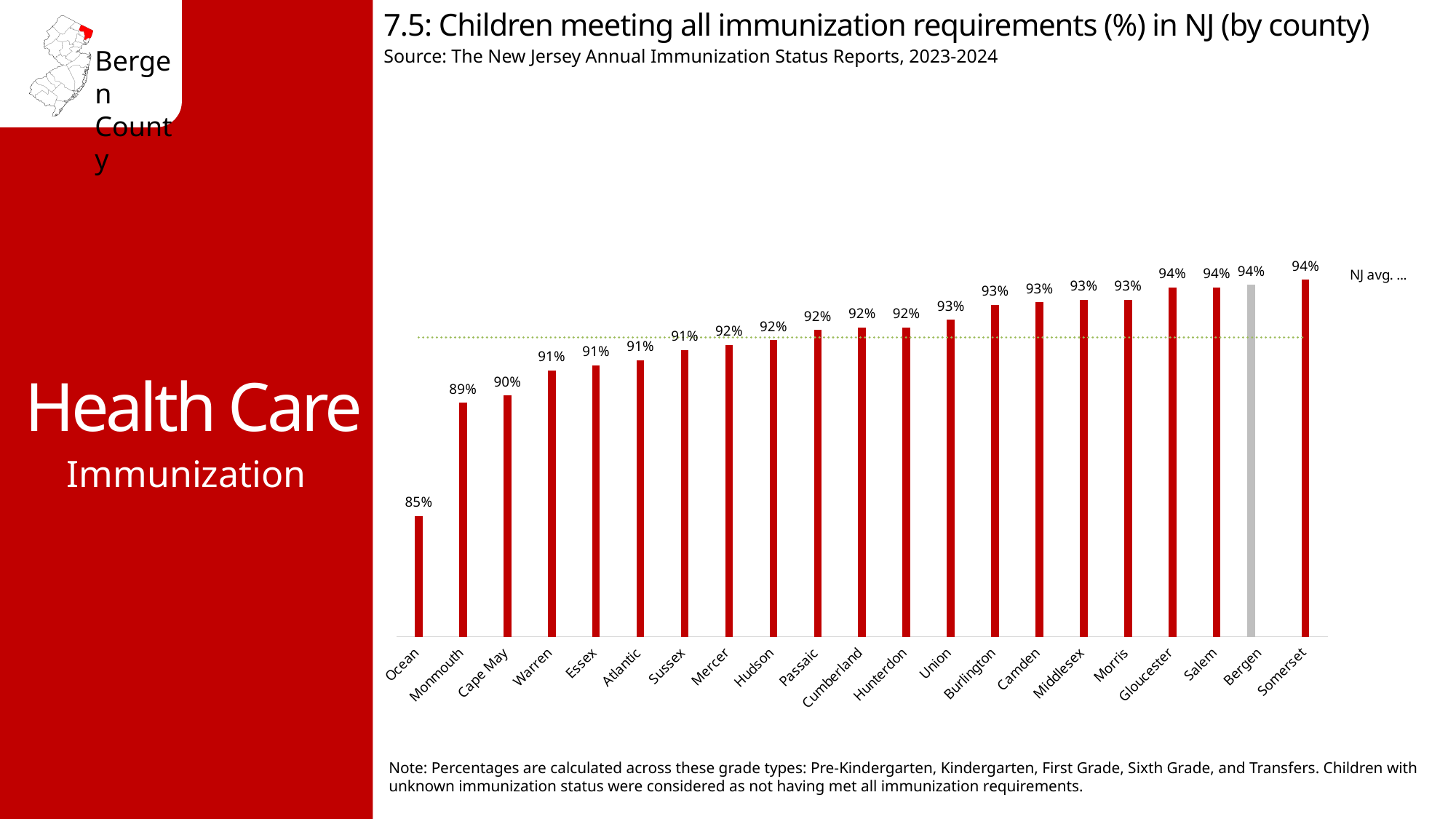
Which county's bar is coloured grey instead of red? Bergen What is the value for Ocean? 85% How many counties are shown on the chart? 21 What is the value for Union? 93% Do the values rise or fall from left to right along the x axis? Rise Which has a larger value, Monmouth or Cape May? Cape May What kind of chart is shown on the slide? Bar chart Which county has the lowest value? Ocean What is the value for Monmouth? 89% What is the value for Bergen? 94% What is the value for Cape May? 90% What is the difference between the values for Bergen and Ocean? 9 percentage points